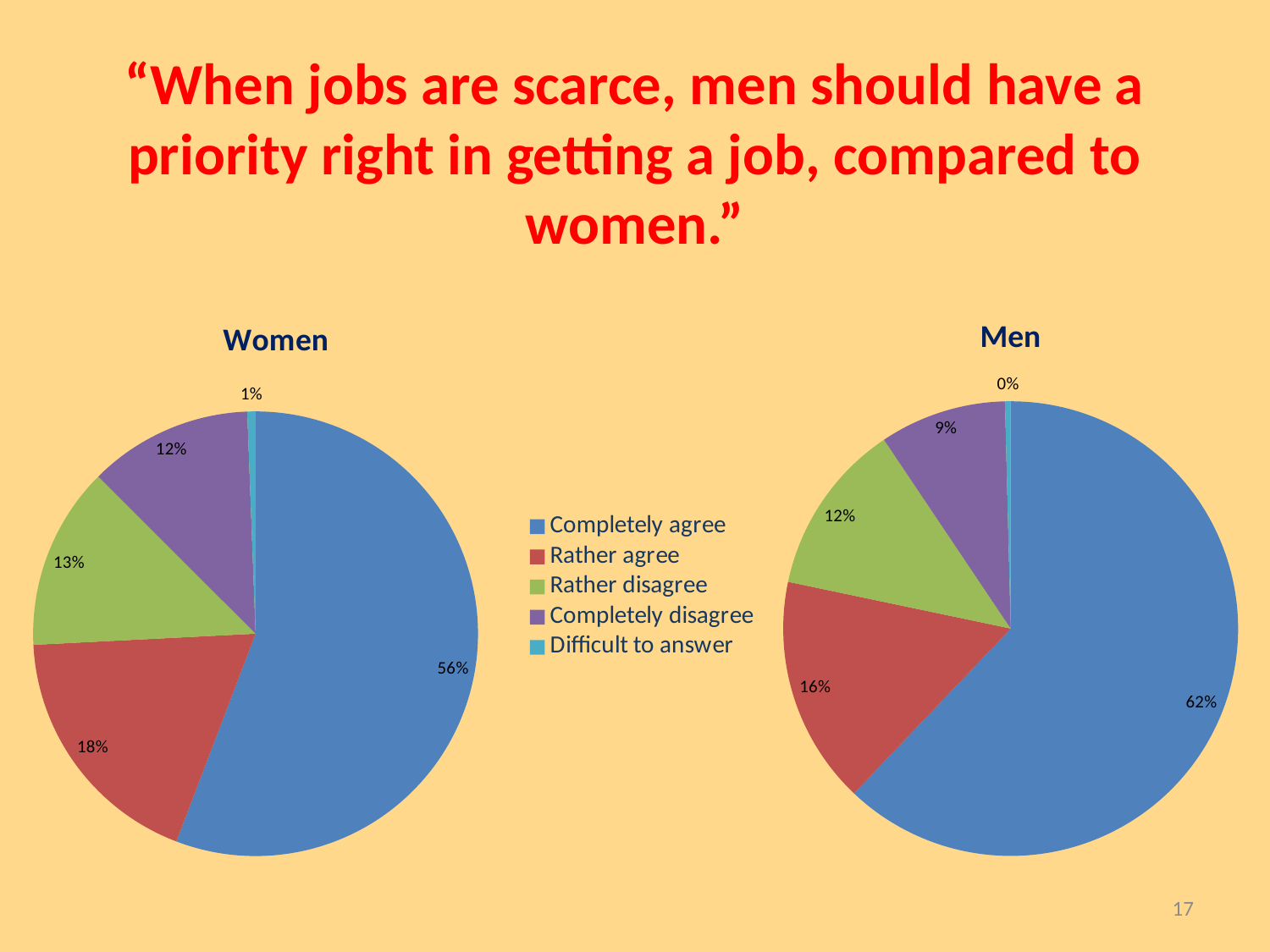
In the Women chart, what share of respondents rather agree? 18% In the Women chart, which response has the smallest slice? Difficult to answer In the Women chart, what share of respondents completely agree? 56% Which is larger: the Rather agree share in the Women chart or in the Men chart? Women Which colour represents Rather disagree in the legend? Green What type of chart is used for the Women and Men data? Pie chart In the Women chart, which response has the largest slice? Completely agree How many response categories does the legend list? 5 What is the difference between the Men and Women shares for Completely agree? 6% In the Men chart, what share of respondents completely agree? 62% In the Men chart, what share of respondents completely disagree? 9% In the Men chart, what share of respondents found it difficult to answer? 0%